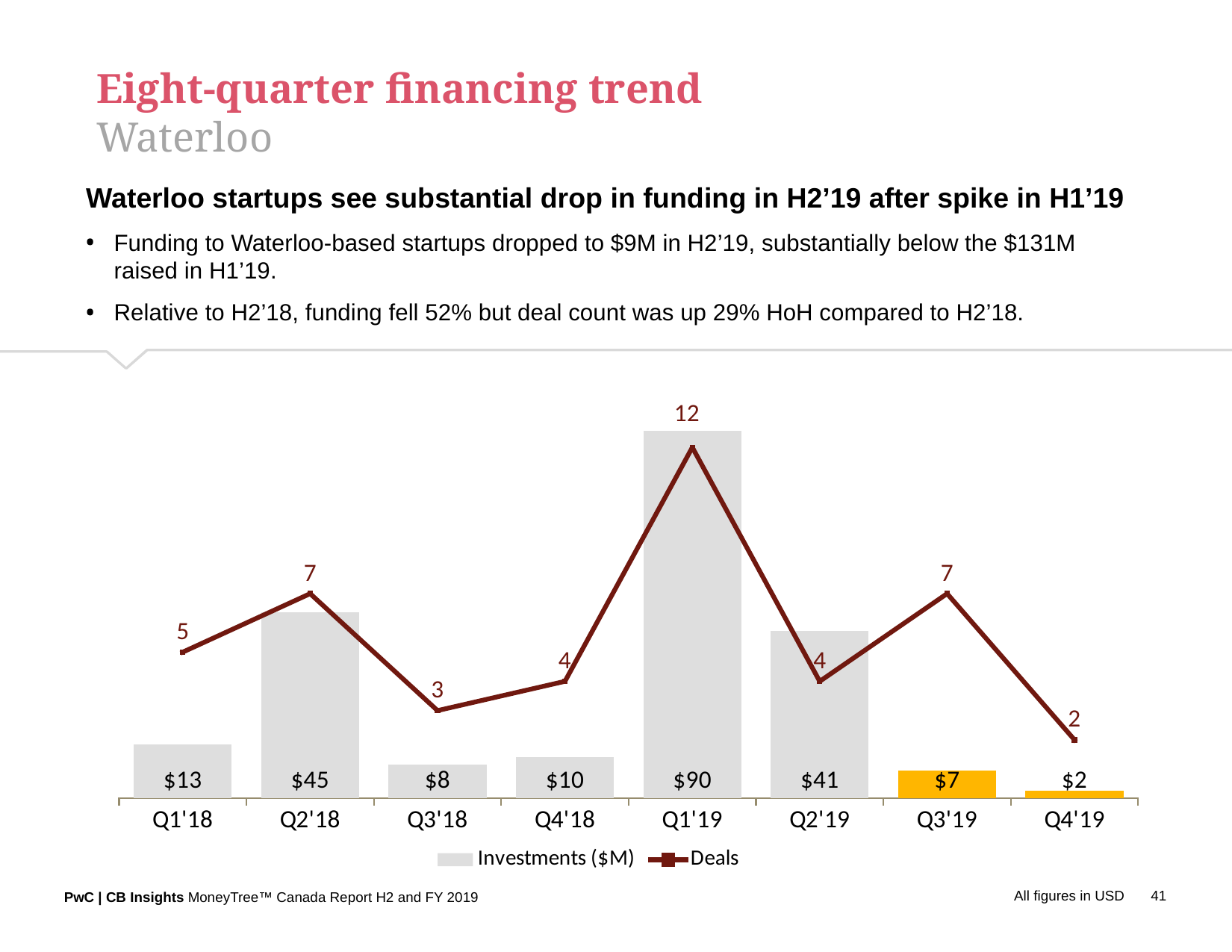
Do the Investments ($M) values rise or fall from Q2'19 to Q4'19? Fall What is the Investments ($M) value for Q1'19? $90 Which quarter has the highest Investments ($M) value? Q1'19 What is the difference in Investments ($M) between Q2'18 and Q3'18? $37 How many quarters are shown on the x axis? 8 What colour are the bars for Q3'19 and Q4'19? Orange/yellow What kind of chart is used to show the Investments ($M) series? Bar chart How many series does the legend list? 2 Which quarter has the lowest number of Deals? Q4'19 Which quarter has more Deals, Q2'18 or Q2'19? Q2'18 What is the difference in Deals between Q1'19 and Q4'19? 10 How many Deals were recorded in Q3'19? 7